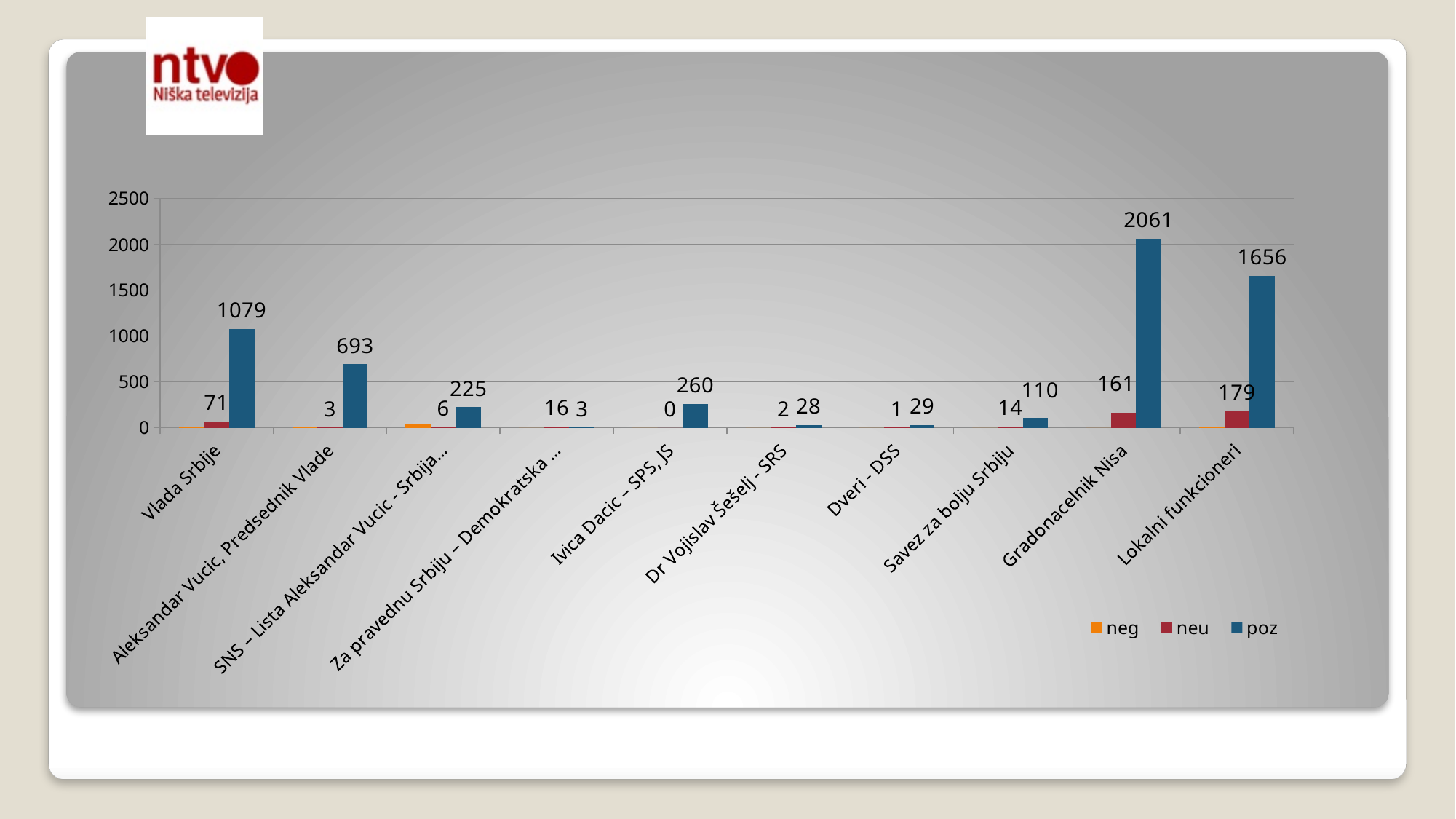
What is the poz value for Gradonacelnik Nisa? 2061 Is the poz value for Lokalni funkcioneri greater or less than 1500? greater How many series does the legend list? 3 Which has the larger poz value, Vlada Srbije or Aleksandar Vucic, Predsednik Vlade? Vlada Srbije How many categories are shown on the x axis? 10 What is the poz value for Vlada Srbije? 1079 What is the neu value for Lokalni funkcioneri? 179 What are the series names listed in the legend? neg, neu, poz What is the difference between the poz values for Gradonacelnik Nisa and Lokalni funkcioneri? 405 Which category has the highest poz value? Gradonacelnik Nisa What is the poz value for Ivica Dacic – SPS,JS? 260 What kind of chart is shown on the slide? bar chart